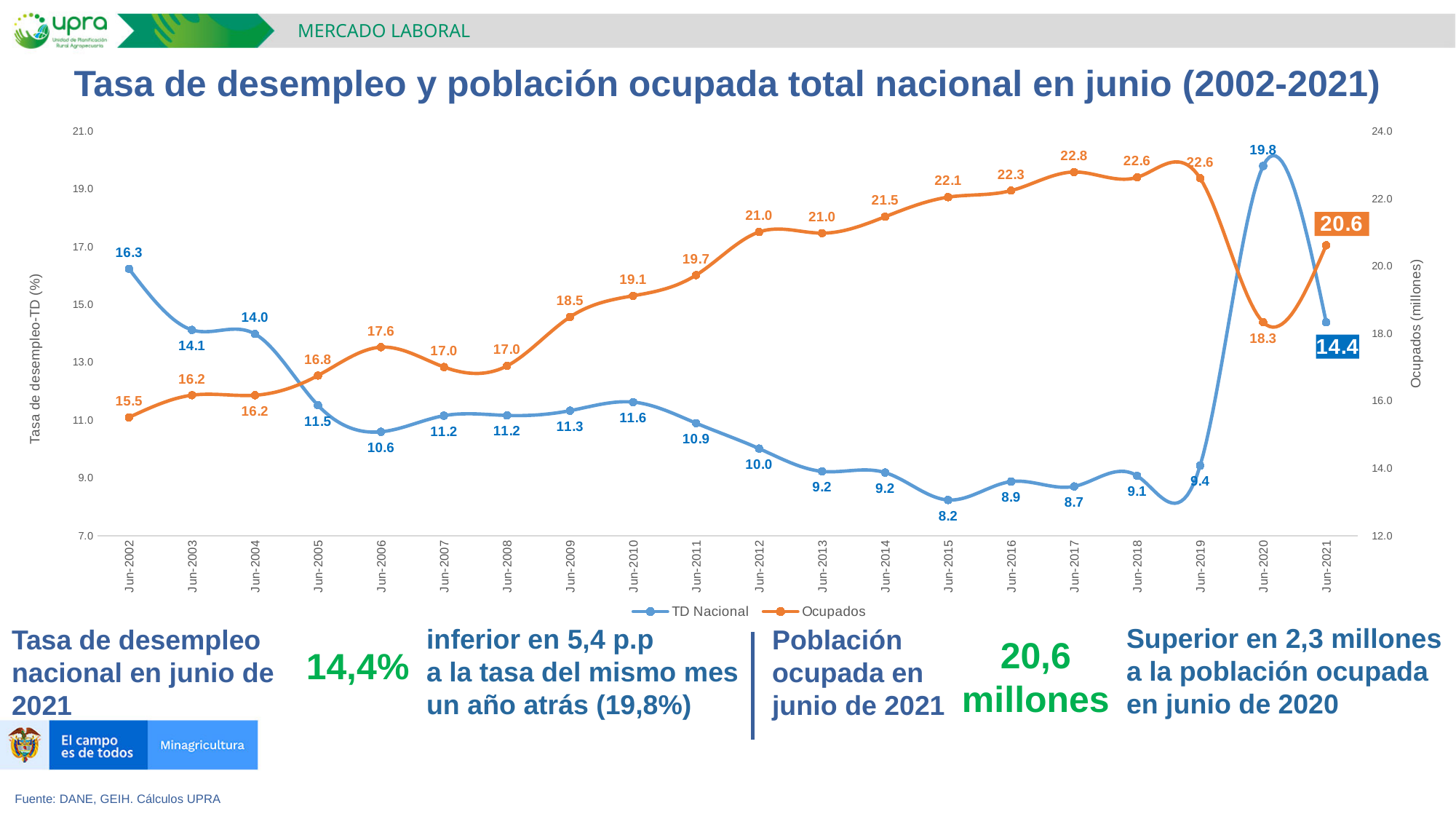
How many data points (months) are plotted along the x axis? 20 In which month is the Ocupados value lowest? Jun-2002 In which month is the TD Nacional value highest? Jun-2020 Does the Ocupados series generally rise or fall from Jun-2002 to Jun-2019? Rise How many series does the legend list? 2 What is the TD Nacional value for Jun-2021? 14.4 What is the Ocupados value for Jun-2017? 22.8 Which is larger, the TD Nacional value for Jun-2002 or for Jun-2006? Jun-2002 What is the difference between the Ocupados values for Jun-2021 and Jun-2020? 2.3 What is the TD Nacional value for Jun-2015? 8.2 What type of chart is shown on the slide? Line chart What is the difference between the TD Nacional values for Jun-2020 and Jun-2021? 5.4